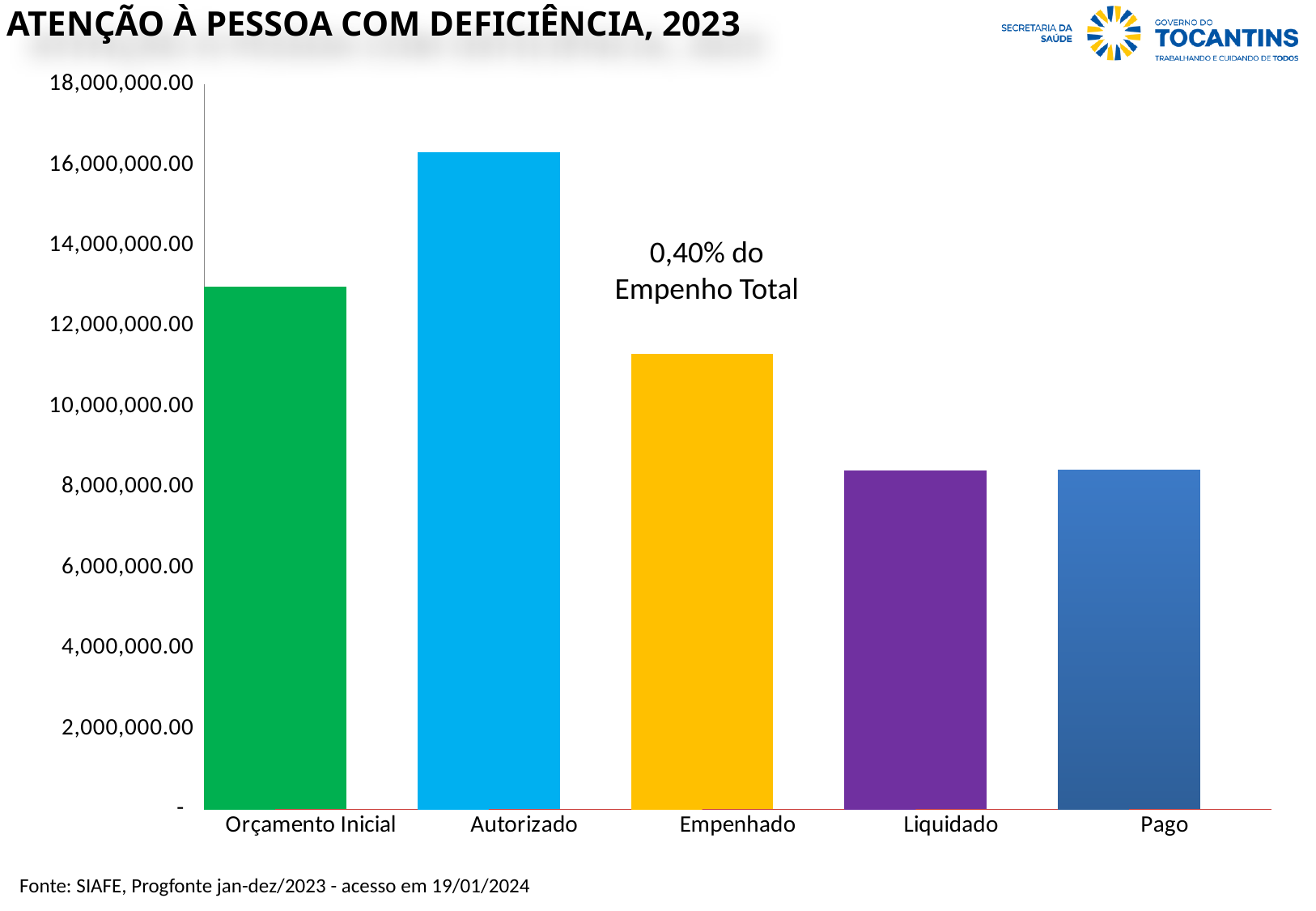
What percentage of the Empenho Total does the annotation above the Empenhado bar state? 0,40% Is the value for Liquidado greater or less than 8,000,000.00? greater Do the values rise or fall from Autorizado to Pago along the x axis? fall Which category has the highest value in the chart? Autorizado Is the value for Pago greater or less than 10,000,000.00? less Which is larger, the value for Autorizado or the value for Liquidado? Autorizado Is the value for Autorizado greater or less than 16,000,000.00? greater What kind of chart is shown on the slide? bar chart How many categories are shown on the x axis of the chart? 5 Which is larger, the value for Orçamento Inicial or the value for Empenhado? Orçamento Inicial